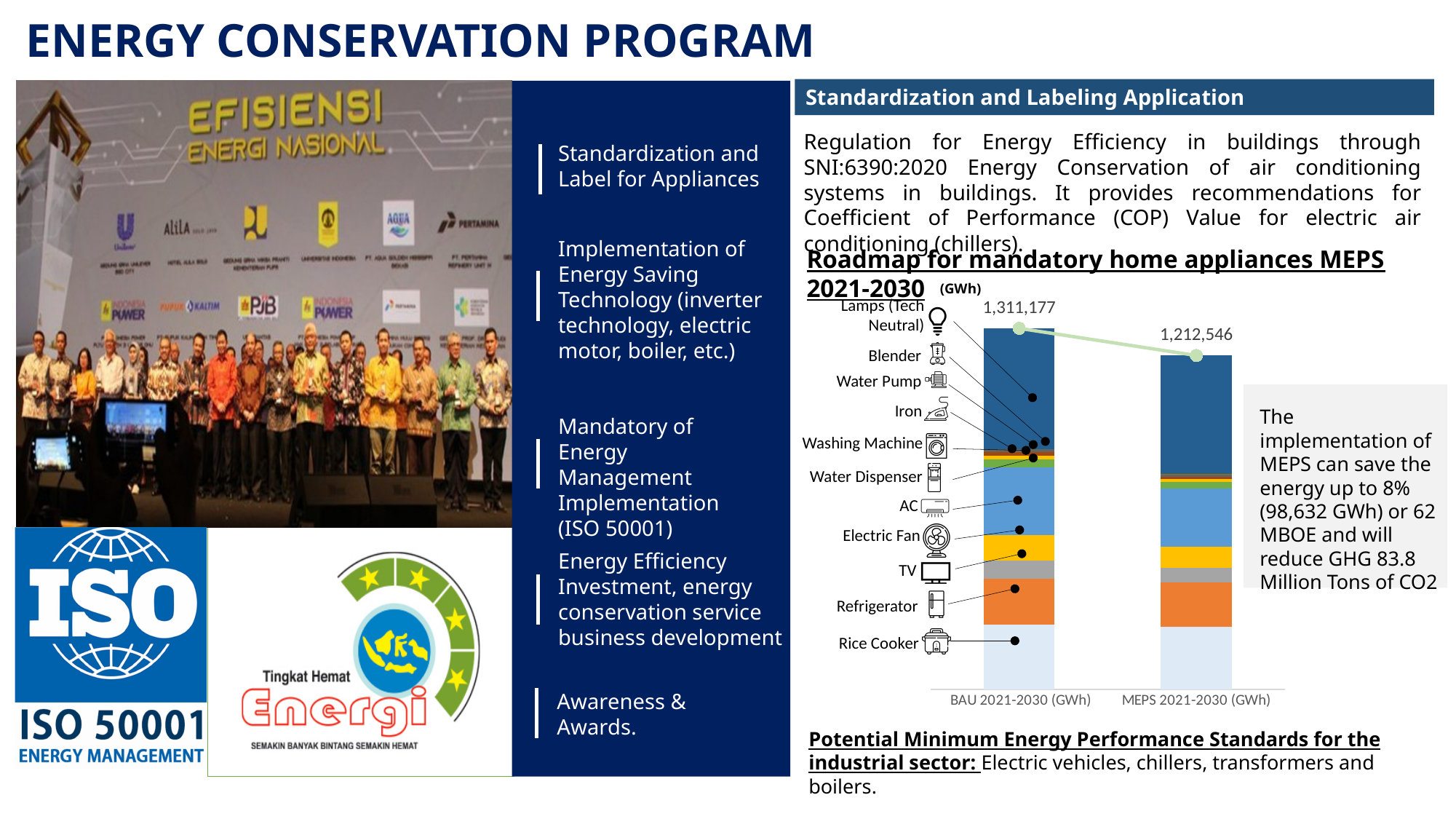
What is the total value of the MEPS 2021-2030 (GWh) bar? 1,212,546 What kind of chart is the 'Roadmap for mandatory home appliances MEPS 2021-2030' chart? Stacked bar chart Which scenario has the lowest total in the chart? MEPS 2021-2030 How many appliance categories are labeled as segments in the stacked bars? 11 How many bars (scenarios) are shown on the x axis of the chart? 2 What is the total value of the BAU 2021-2030 (GWh) bar? 1,311,177 Does the total value rise or fall from the BAU 2021-2030 bar to the MEPS 2021-2030 bar? Fall Which scenario has the highest total in the chart? BAU 2021-2030 Which bar has the higher total, BAU 2021-2030 or MEPS 2021-2030? BAU 2021-2030 Which appliance forms the largest segment of the BAU 2021-2030 bar? Lamps (Tech Neutral) Which appliance is labeled at the bottom segment of the stacked bars? Rice Cooker What unit is the chart's data expressed in? GWh